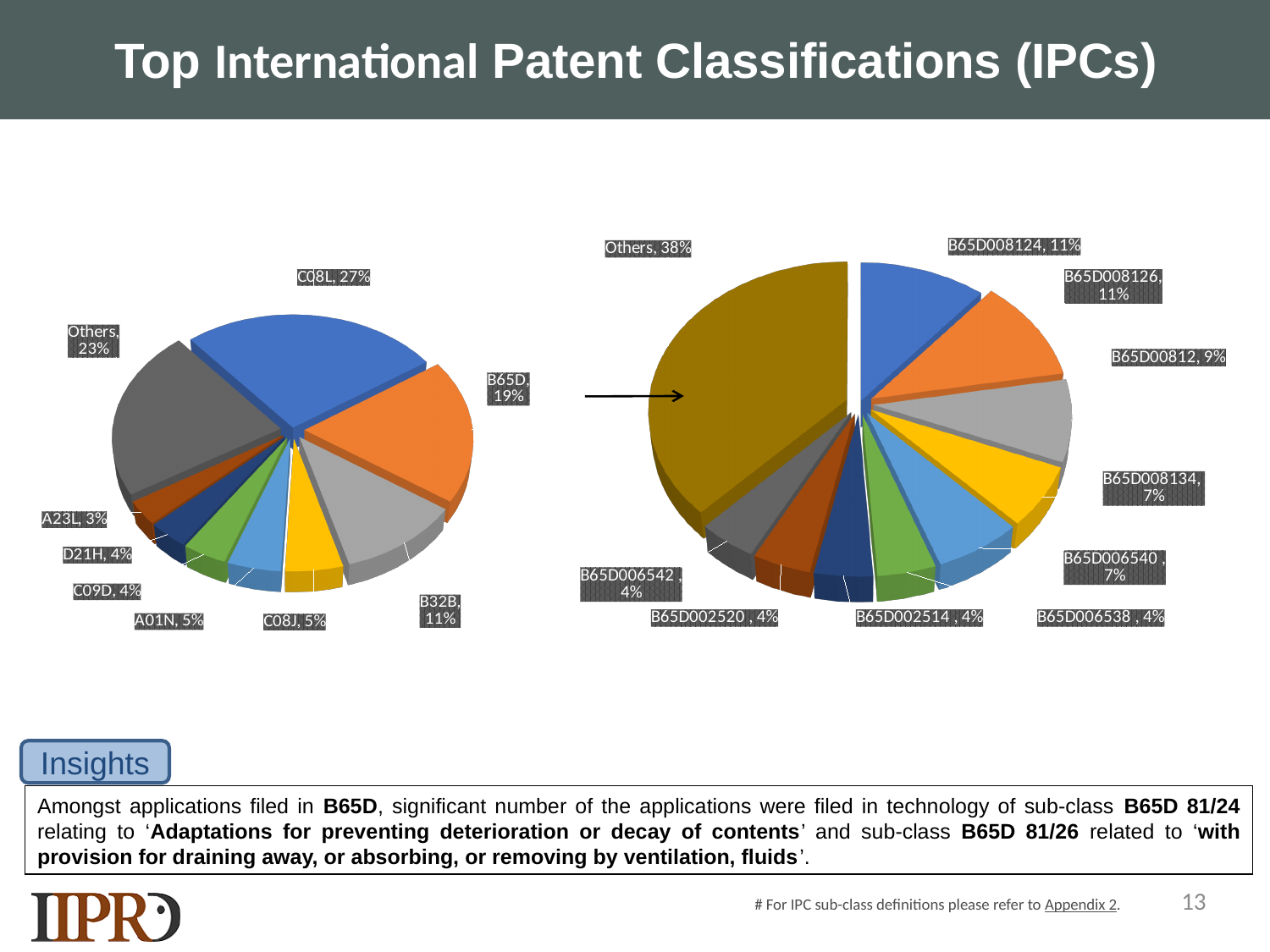
In the left pie chart, what share does C08L have? 27% How many slices does the left pie chart have? 9 In the left pie chart, what is the difference between the shares of C08L and B65D? 8% In the right pie chart, what share does Others have? 38% In the left pie chart, which IPC has the smallest share? A23L In the right pie chart, what share does B65D00812 have? 9% In the left pie chart, what share does B65D have? 19% In the left pie chart, which named IPC (excluding Others) has the largest share? C08L In the left pie chart, which has a larger share, B32B or C08J? B32B How many slices does the right pie chart have? 10 What type of chart is used on this slide? Pie chart In the right pie chart, what is the difference between the shares of B65D008124 and B65D008134? 4%